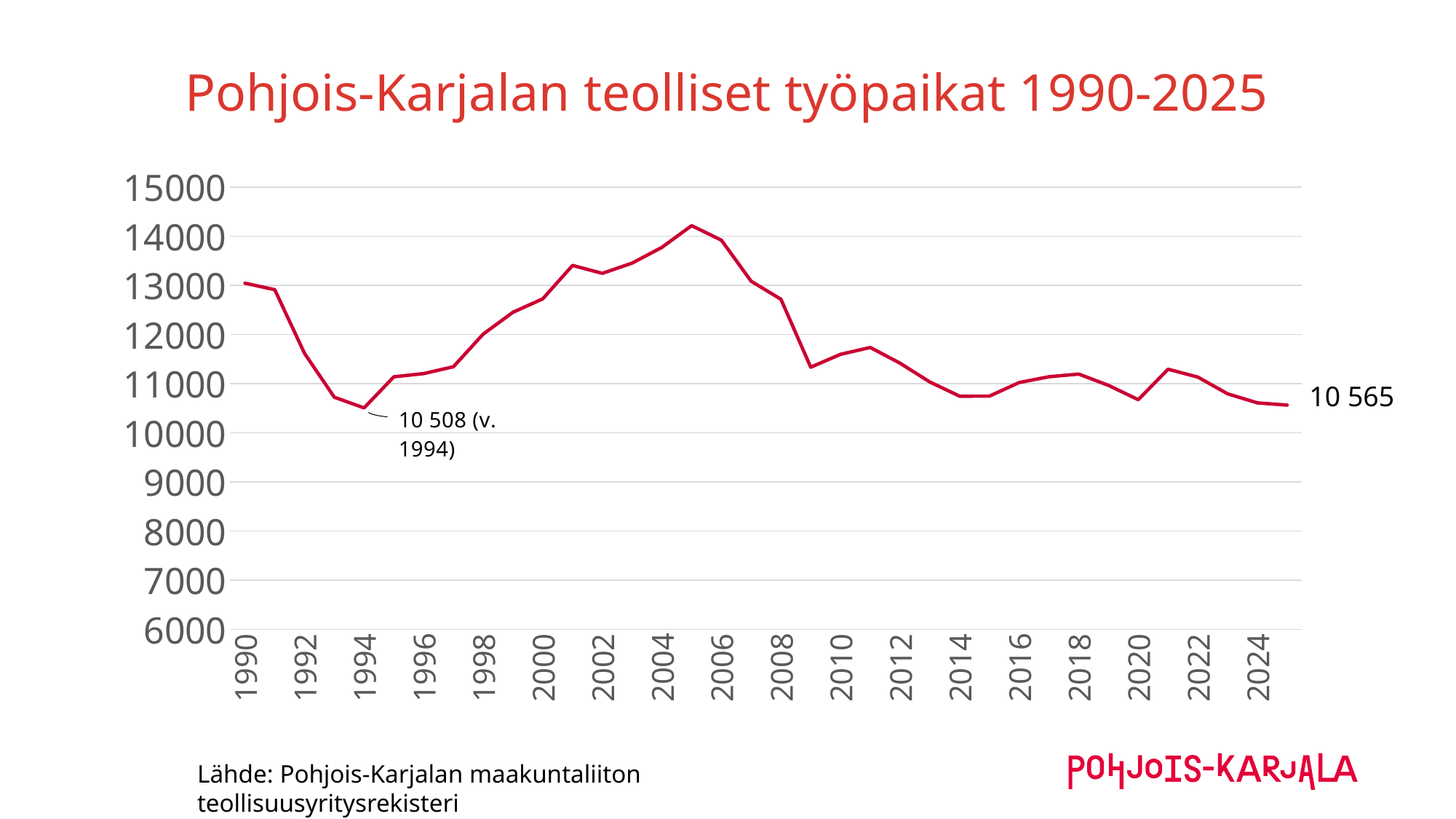
What is the labelled value at the end of the line, for 2025? 10 565 Does the line rise or fall between 1990 and 1994? fall In which year does the line reach its lowest point? 1994 What is the difference between the 2025 value (10 565) and the 1994 value (10 508)? 57 Is the value for 2014 greater or less than 11000? less What kind of chart is shown on the slide? line chart Is the value for 1990 greater or less than 12000? greater In which year does the line reach its highest point? 2005 What is the title of the chart? Pohjois-Karjalan teolliset työpaikat 1990-2025 What is the labelled value for 1994? 10 508 Is the value for 2005 greater or less than 14000? greater Which is larger, the value for 1994 or the value for 2025? 2025